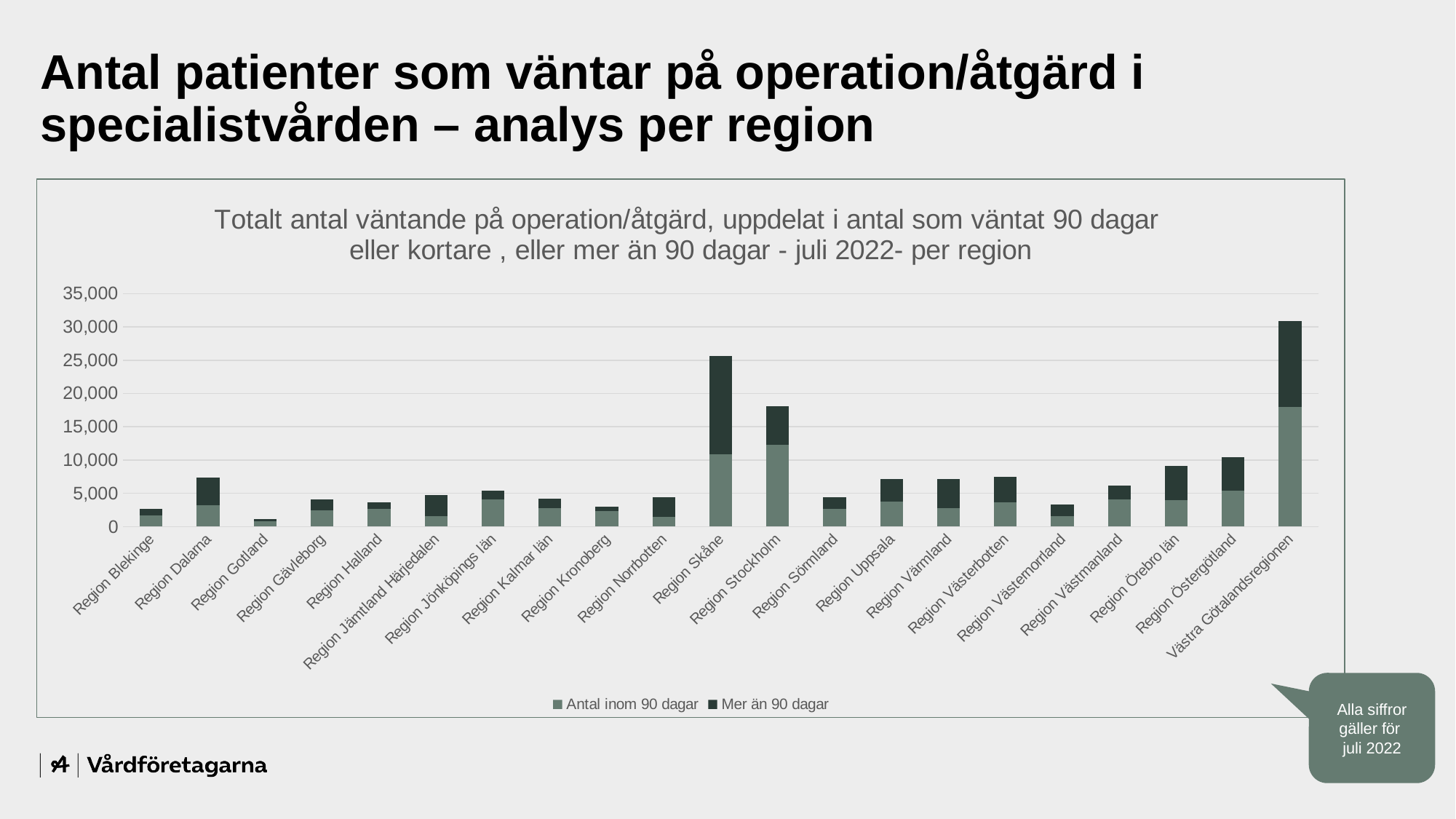
How many series does the legend list? 2 What are the two series named in the legend? Antal inom 90 dagar; Mer än 90 dagar Is the total value for Region Skåne greater or less than 20,000? greater How many regions are shown on the x axis? 21 According to the callout on the slide, which month do all the figures apply to? juli 2022 Is the total value for Region Stockholm greater or less than 15,000? greater Which has a larger total of waiting patients, Region Skåne or Region Stockholm? Region Skåne Is the total value for Västra Götalandsregionen greater or less than 25,000? greater What kind of chart is shown on the slide? Stacked bar chart Which region has the highest total number of waiting patients? Västra Götalandsregionen Which region has the lowest total number of waiting patients? Region Gotland